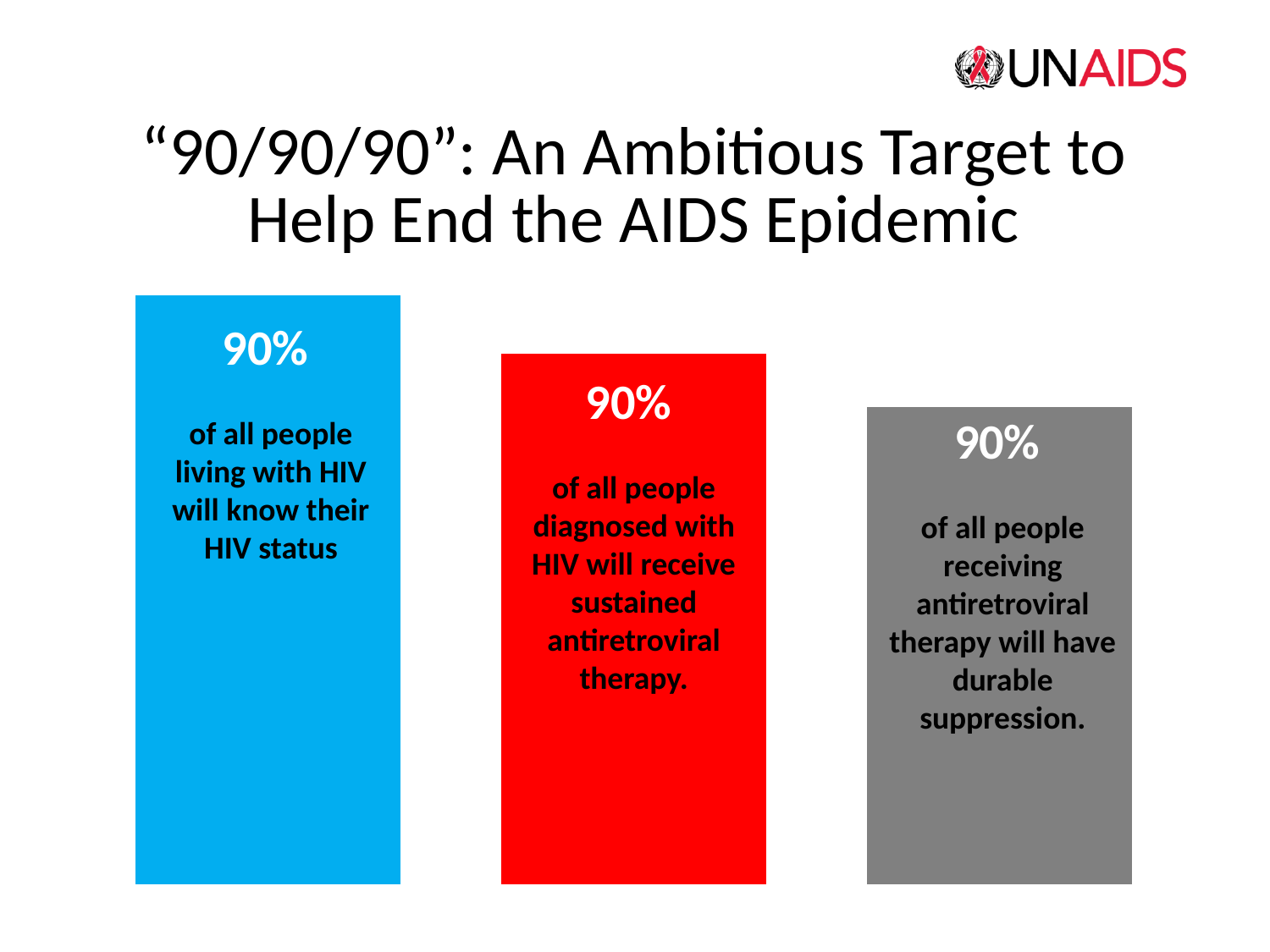
What kind of chart is shown on the slide? bar chart What value is printed on the red bar for people diagnosed with HIV who will receive sustained antiretroviral therapy? 90% What is the title of the slide? "90/90/90": An Ambitious Target to Help End the AIDS Epidemic What is the difference between the value on the blue bar and the value on the grey bar? 0% Is the value printed on the red bar greater or less than 50%? greater What colour is the bar for people diagnosed with HIV who will receive sustained antiretroviral therapy? red How many bars are shown on the slide? 3 What value is printed on the grey bar for people receiving antiretroviral therapy who will have durable suppression? 90% What value is printed on the blue bar for people living with HIV who will know their HIV status? 90%